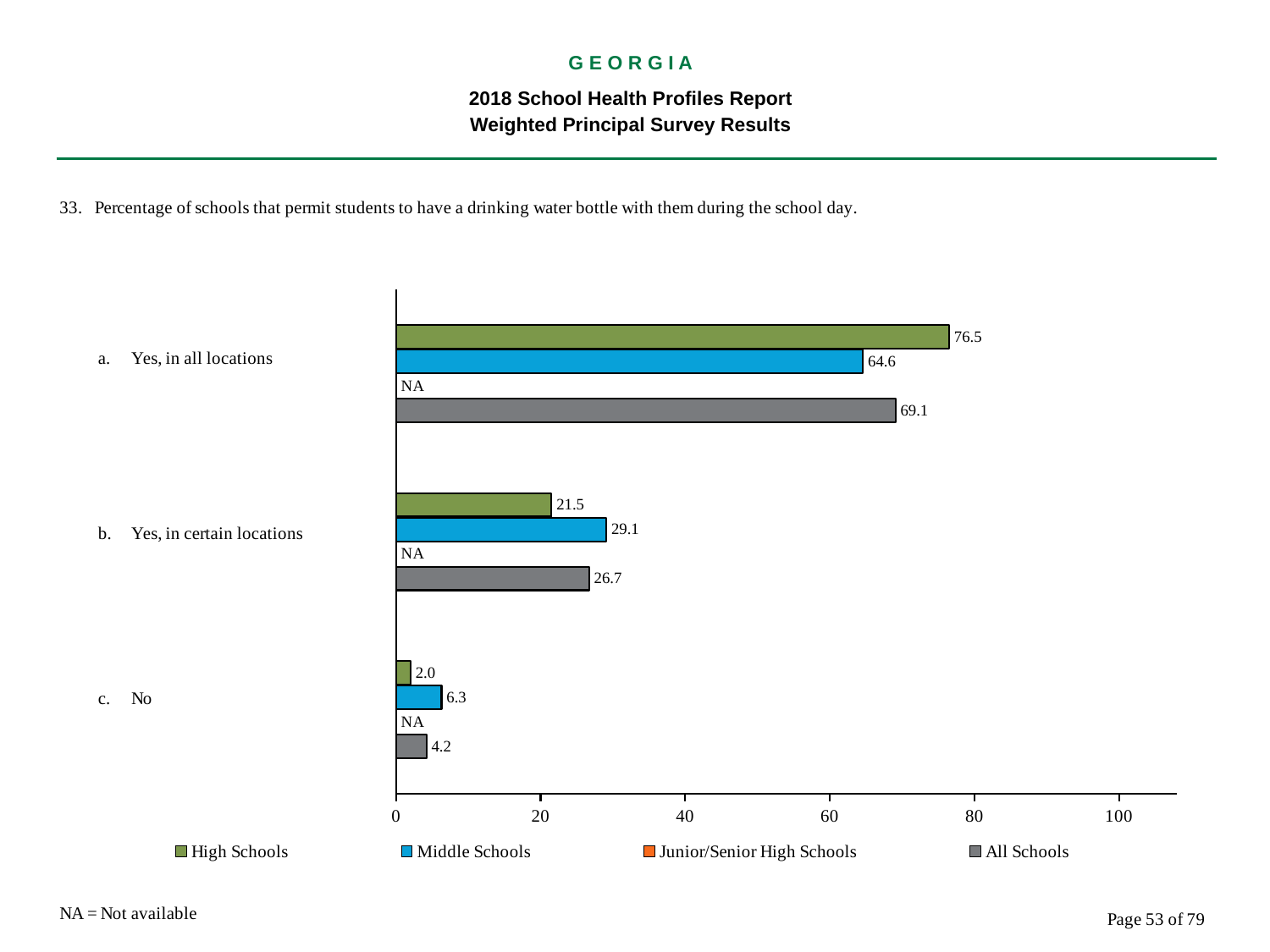
How many series does the legend list? 4 Which category has the lowest value for High Schools? No What is the difference between the High Schools and Middle Schools values for "Yes, in all locations"? 11.9 For "Yes, in certain locations", which is larger: High Schools or Middle Schools? Middle Schools Is the value for All Schools for "Yes, in all locations" greater or less than 60? greater What is the value for All Schools for "No"? 4.2 What kind of chart is shown on the slide? bar chart What is the value for High Schools for "Yes, in all locations"? 76.5 What is shown for Junior/Senior High Schools for "Yes, in all locations"? NA Which category has the highest value for All Schools? Yes, in all locations How many categories are shown on the chart? 3 What is the value for Middle Schools for "Yes, in certain locations"? 29.1